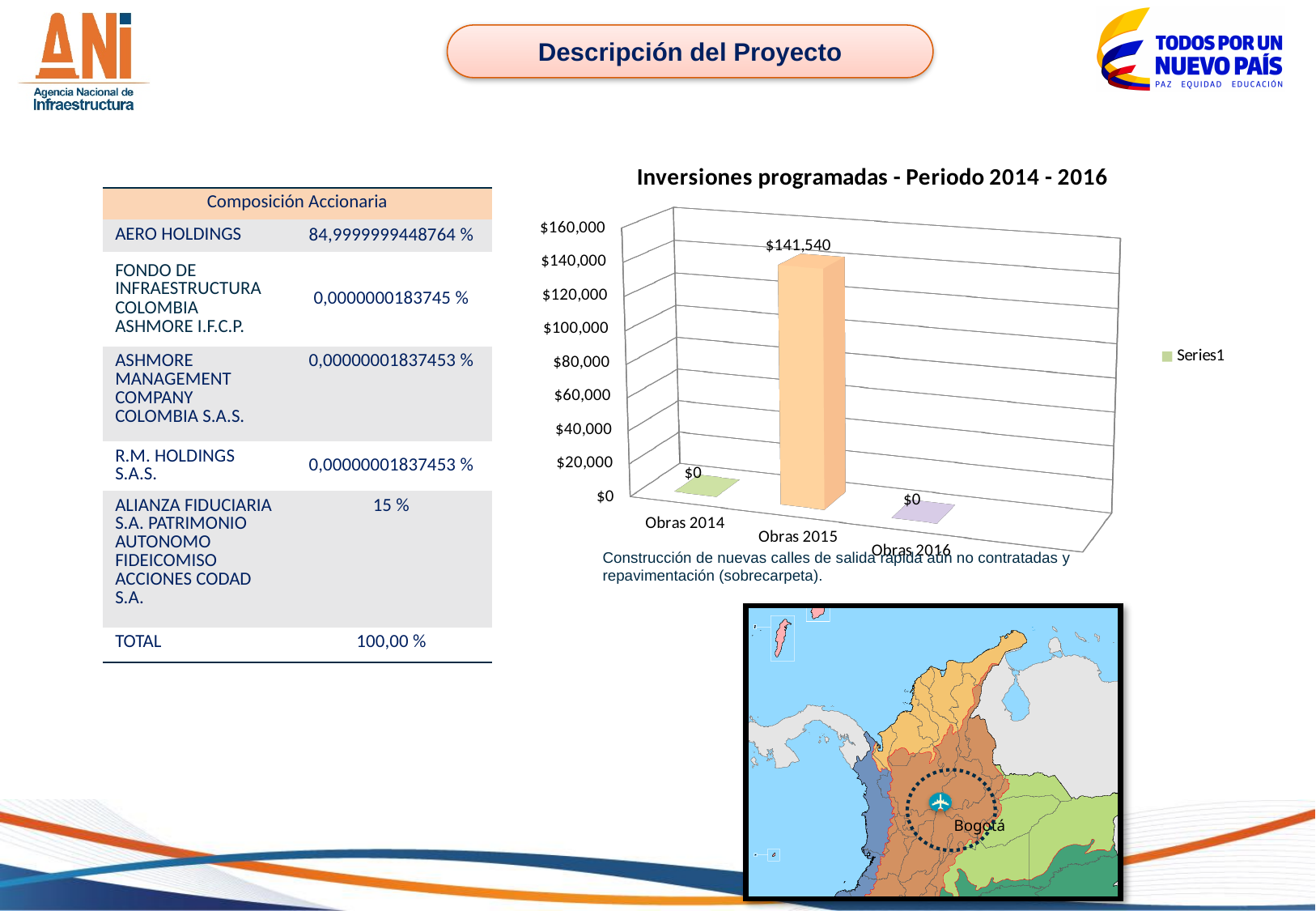
What is the title of the chart? Inversiones programadas - Periodo 2014 - 2016 What is the difference between the values for Obras 2015 and Obras 2014? $141,540 Which category has the highest value in the chart? Obras 2015 How many categories are shown on the x axis of the chart? 3 What kind of chart is shown on the slide? bar chart Which is larger, the value for Obras 2015 or the value for Obras 2016? Obras 2015 What is the value for Obras 2016 in the chart? $0 What is the value for Obras 2015 in the chart? $141,540 How many series does the chart legend list? 1 Is the value for Obras 2015 greater or less than $140,000? greater What is the value for Obras 2014 in the chart? $0 What is the name of the series listed in the chart legend? Series1